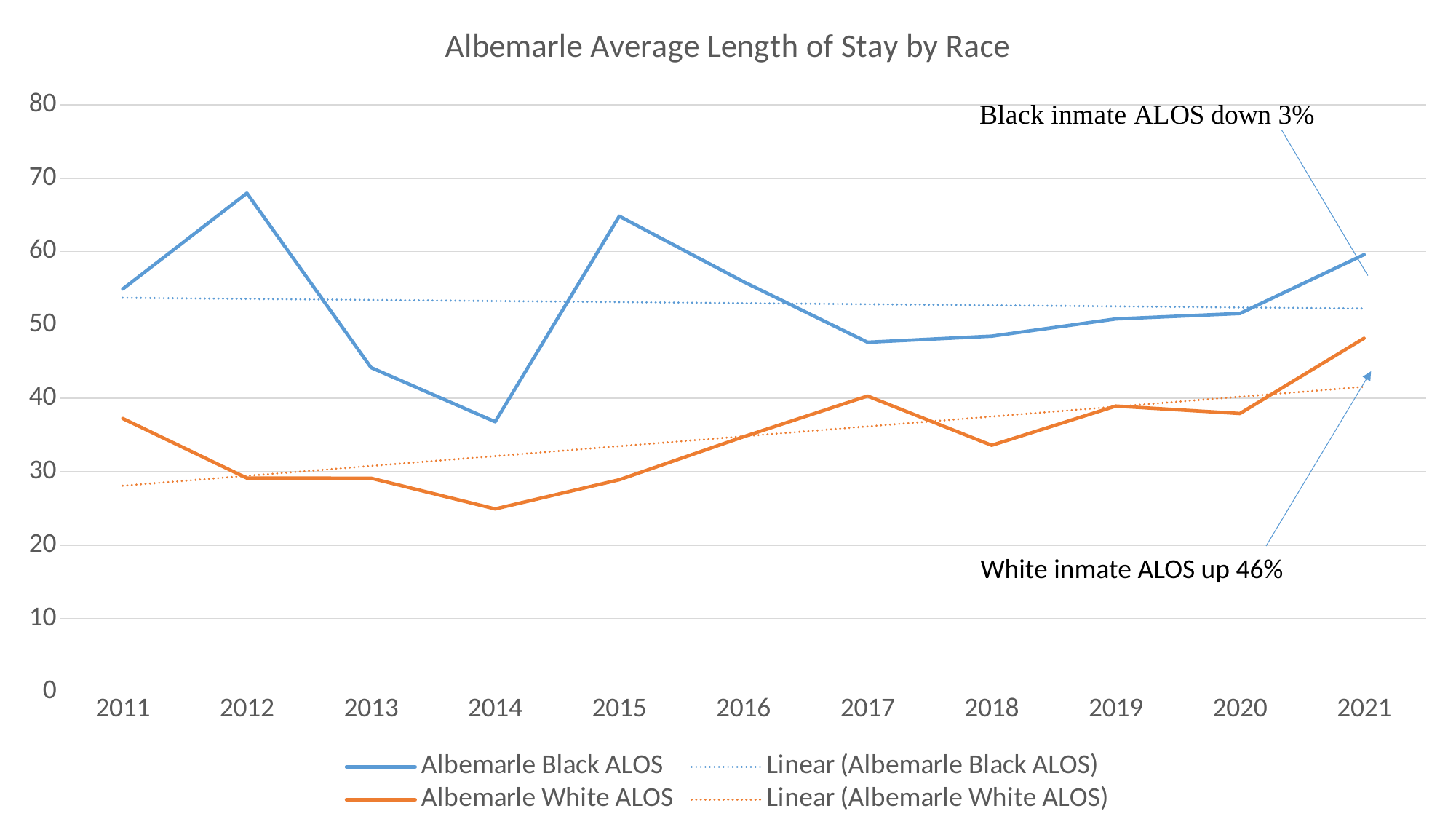
How many entries does the legend list? 4 Which series has the larger value in 2015, Albemarle Black ALOS or Albemarle White ALOS? Albemarle Black ALOS According to the annotation, by what percentage did White inmate ALOS change? up 46% What kind of chart is shown on the slide? line chart How many years are shown on the x axis? 11 In which year is the Albemarle White ALOS lowest? 2014 In which year is the Albemarle White ALOS highest? 2021 In which year is the Albemarle Black ALOS lowest? 2014 Is the Albemarle Black ALOS value for 2012 greater or less than 60? greater Is the Albemarle White ALOS value for 2014 greater or less than 30? less In which year is the Albemarle Black ALOS highest? 2012 What is the title of the chart? Albemarle Average Length of Stay by Race